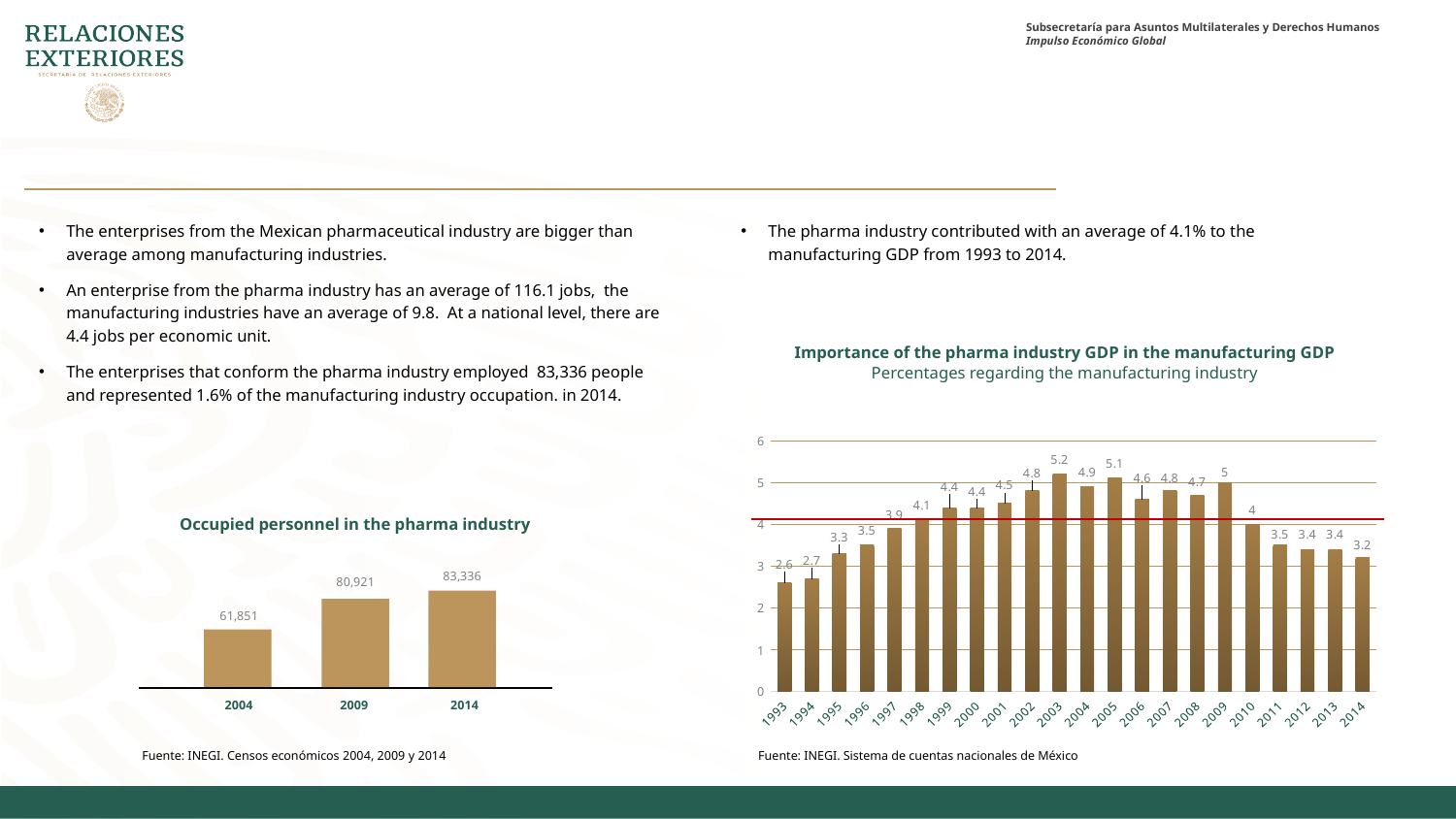
In the 'Occupied personnel in the pharma industry' chart, do the values rise or fall from 2004 to 2014? rise In the 'Importance of the pharma industry GDP in the manufacturing GDP' chart, which year has the highest value? 2003 In the 'Importance of the pharma industry GDP in the manufacturing GDP' chart, which year has the lowest value? 1993 In the 'Importance of the pharma industry GDP in the manufacturing GDP' chart, what is the value for 2003? 5.2 In the 'Importance of the pharma industry GDP in the manufacturing GDP' chart, how many years are plotted? 22 What kind of chart is the 'Importance of the pharma industry GDP in the manufacturing GDP' chart? bar chart In the 'Occupied personnel in the pharma industry' chart, what is the difference between the 2014 and 2004 values? 21,485 In the 'Occupied personnel in the pharma industry' chart, which year has the lowest value? 2004 In the 'Occupied personnel in the pharma industry' chart, what is the value for 2009? 80,921 In the 'Importance of the pharma industry GDP in the manufacturing GDP' chart, what is the value for 2014? 3.2 In the 'Occupied personnel in the pharma industry' chart, how many years are shown? 3 In the 'Importance of the pharma industry GDP in the manufacturing GDP' chart, which is larger, the value for 1997 or the value for 2010? 2010